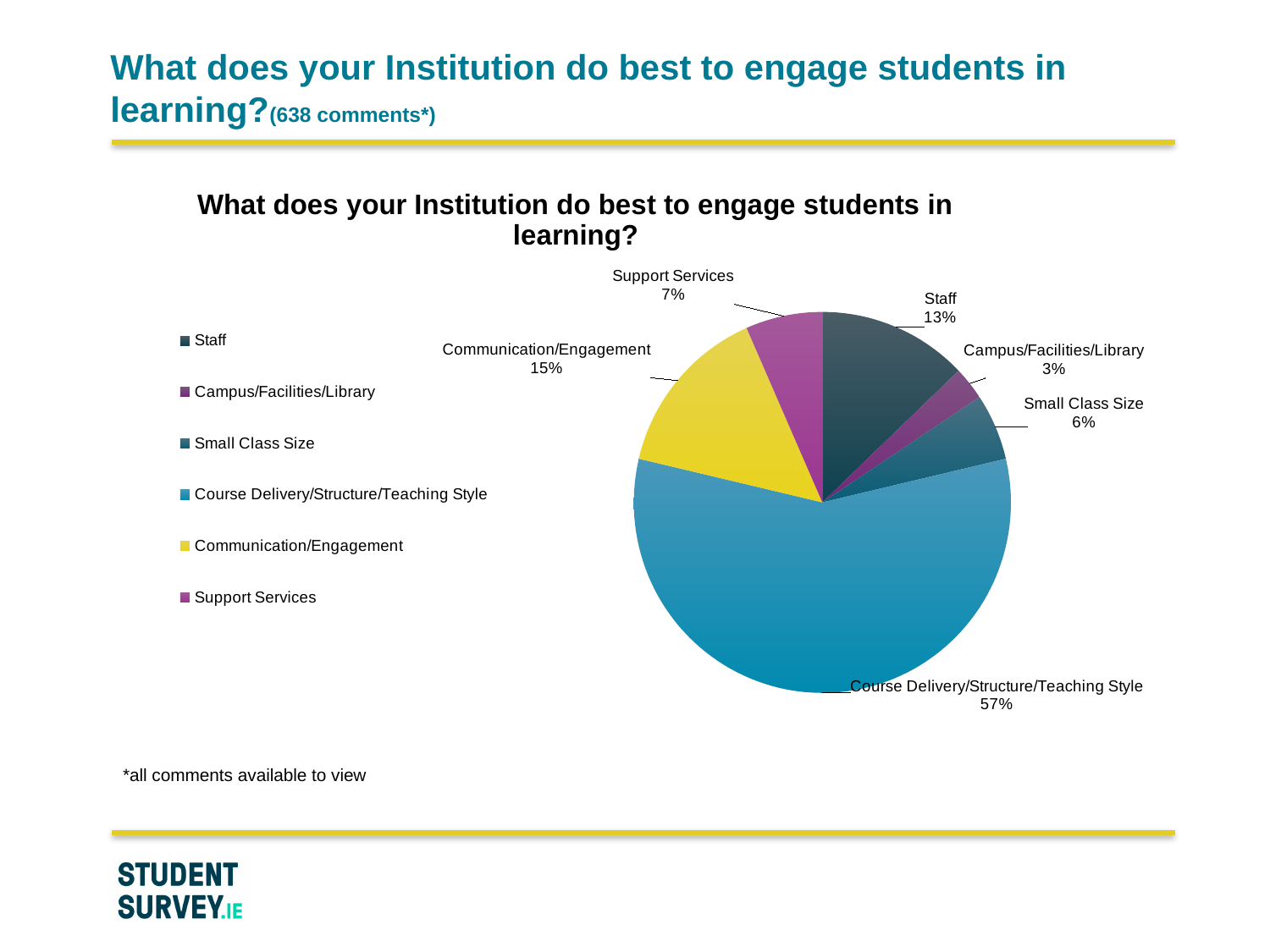
Which category has the largest slice of the pie? Course Delivery/Structure/Teaching Style What type of chart is shown on the slide? pie chart Which category has the smallest slice of the pie? Campus/Facilities/Library How many categories are shown in the pie chart? 6 What is the value shown for Staff? 13% What is the value shown for Support Services? 7% What is the difference in percentage points between Communication/Engagement and Staff? 2 What is the difference in percentage points between Course Delivery/Structure/Teaching Style and Campus/Facilities/Library? 54 What is the value shown for Communication/Engagement? 15% What is the title of the chart? What does your Institution do best to engage students in learning? Which is larger, Small Class Size or Support Services? Support Services What share of the pie does Course Delivery/Structure/Teaching Style represent? 57%